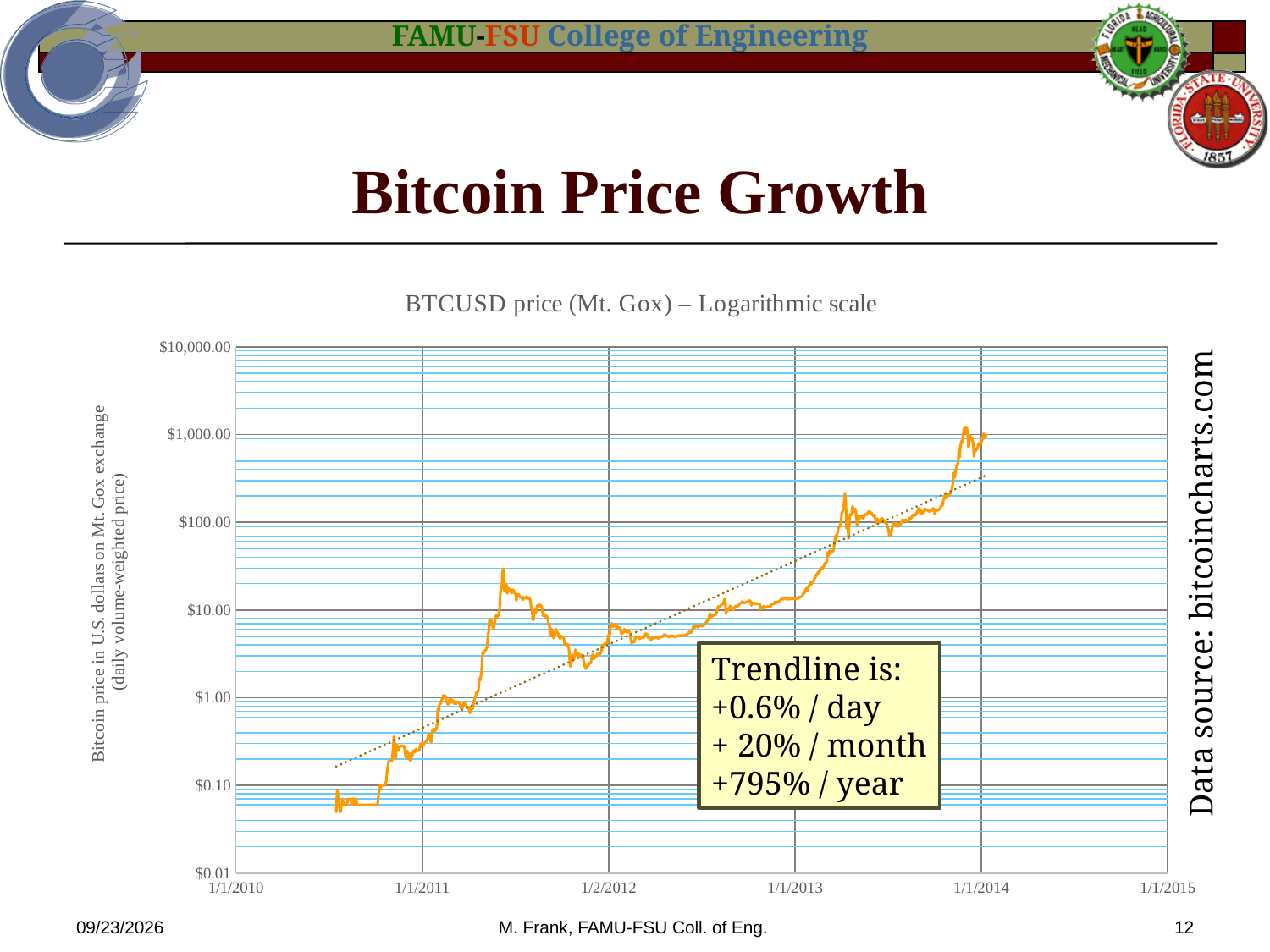
According to the text box on the chart, what is the trendline growth per day? +0.6% / day According to the text box on the chart, what is the trendline growth per year? +795% / year Is the Bitcoin price at 1/1/2014 greater or less than $10,000.00? less Does the Bitcoin price generally rise or fall from 1/1/2010 to 1/1/2014? rise Is the Bitcoin price at 1/2/2012 greater or less than $1.00? greater Is the Bitcoin price at 1/1/2011 greater or less than $1.00? less What is the highest value labeled on the y axis? $10,000.00 What is the title of the chart? BTCUSD price (Mt. Gox) – Logarithmic scale What kind of chart is shown on the slide? line chart Is the Bitcoin price higher at 1/1/2014 or at 1/1/2011? 1/1/2014